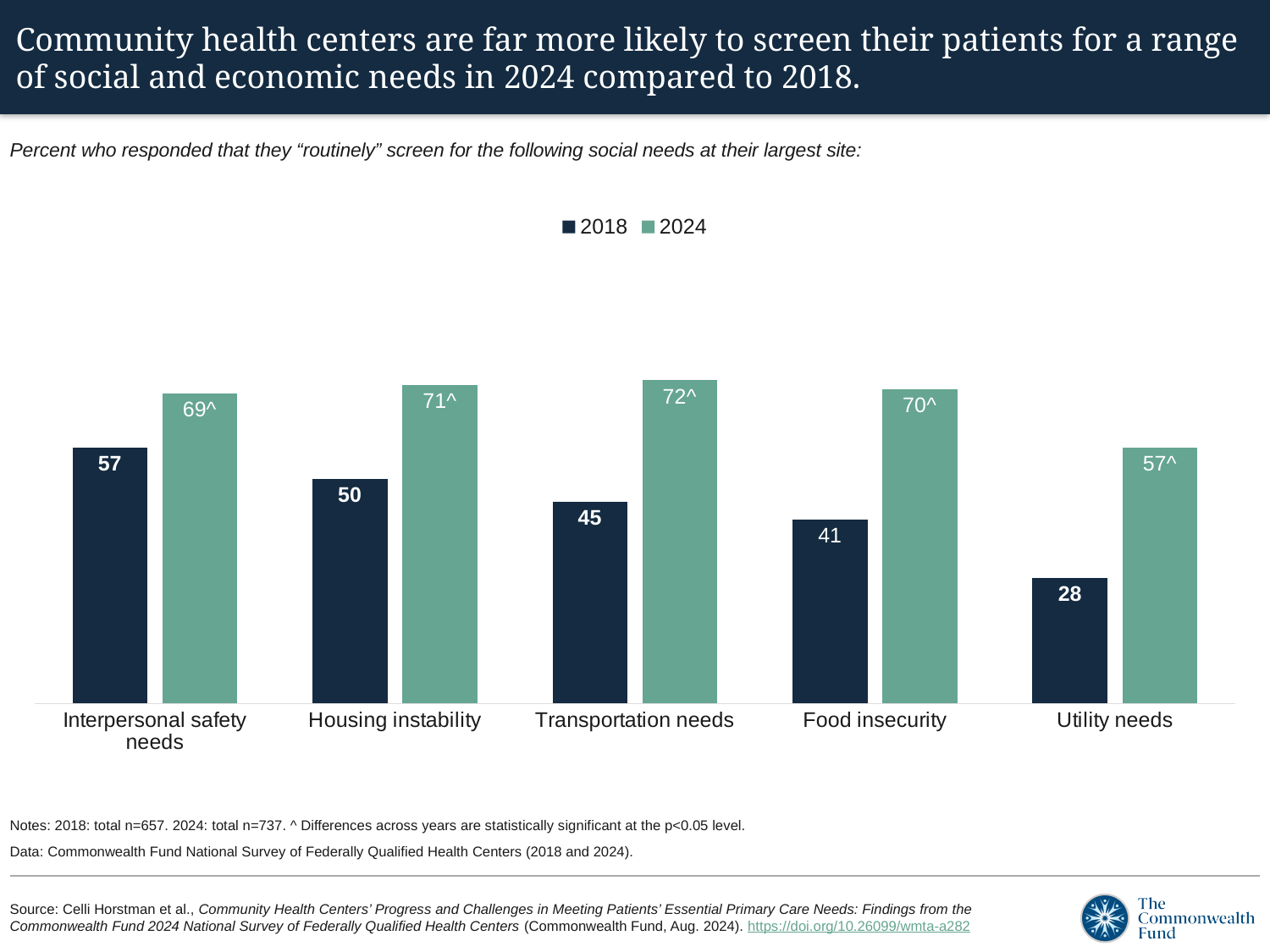
What is the 2024 value shown for food insecurity? 70^ By how many percentage points did screening for utility needs increase from 2018 to 2024? 29 What is the 2024 value shown for transportation needs? 72^ What is the 2018 value for utility needs? 28 How many series does the legend list? 2 Which social need has the lowest 2018 value? Utility needs What percent of community health centers routinely screened for interpersonal safety needs in 2018? 57 Which is larger: the 2018 value for food insecurity or the 2018 value for transportation needs? Transportation needs What type of chart is shown on the slide? Bar chart How many social need categories are shown on the chart? 5 Which social need has the highest 2024 value? Transportation needs What is the difference between the 2024 and 2018 values for housing instability? 21